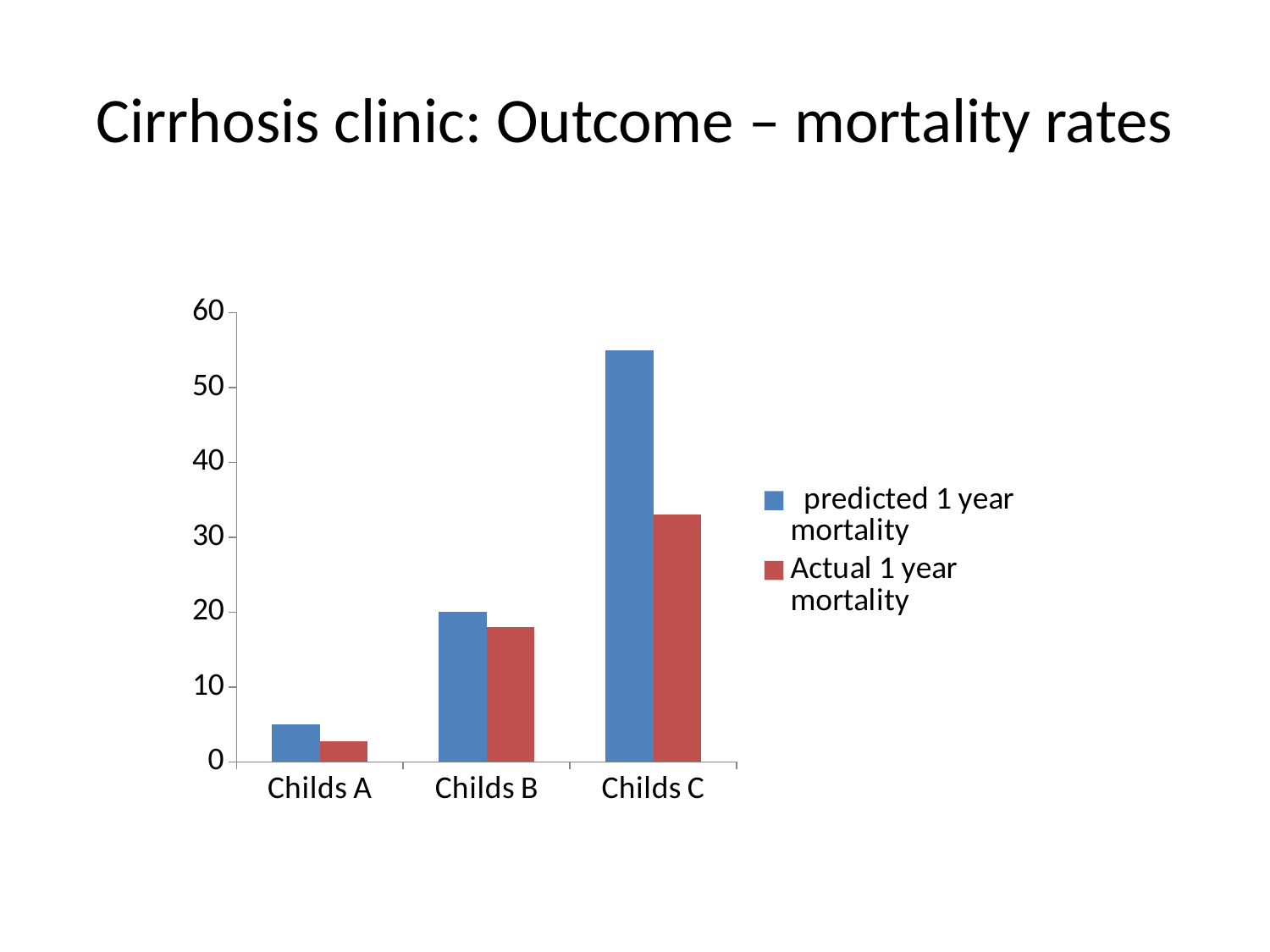
Is the actual 1 year mortality for Childs B greater or less than 20? less For Childs C, which is larger: predicted 1 year mortality or actual 1 year mortality? predicted 1 year mortality Is the predicted 1 year mortality for Childs C greater or less than 50? greater Which category has the lowest actual 1 year mortality? Childs A Do the predicted 1 year mortality values rise or fall from Childs A to Childs C? rise Is the actual 1 year mortality for Childs C greater or less than 30? greater What colour are the bars for actual 1 year mortality? red How many categories are shown on the x axis of the chart? 3 What kind of chart is shown on the slide? bar chart Which category has the highest predicted 1 year mortality? Childs C How many series does the chart's legend list? 2